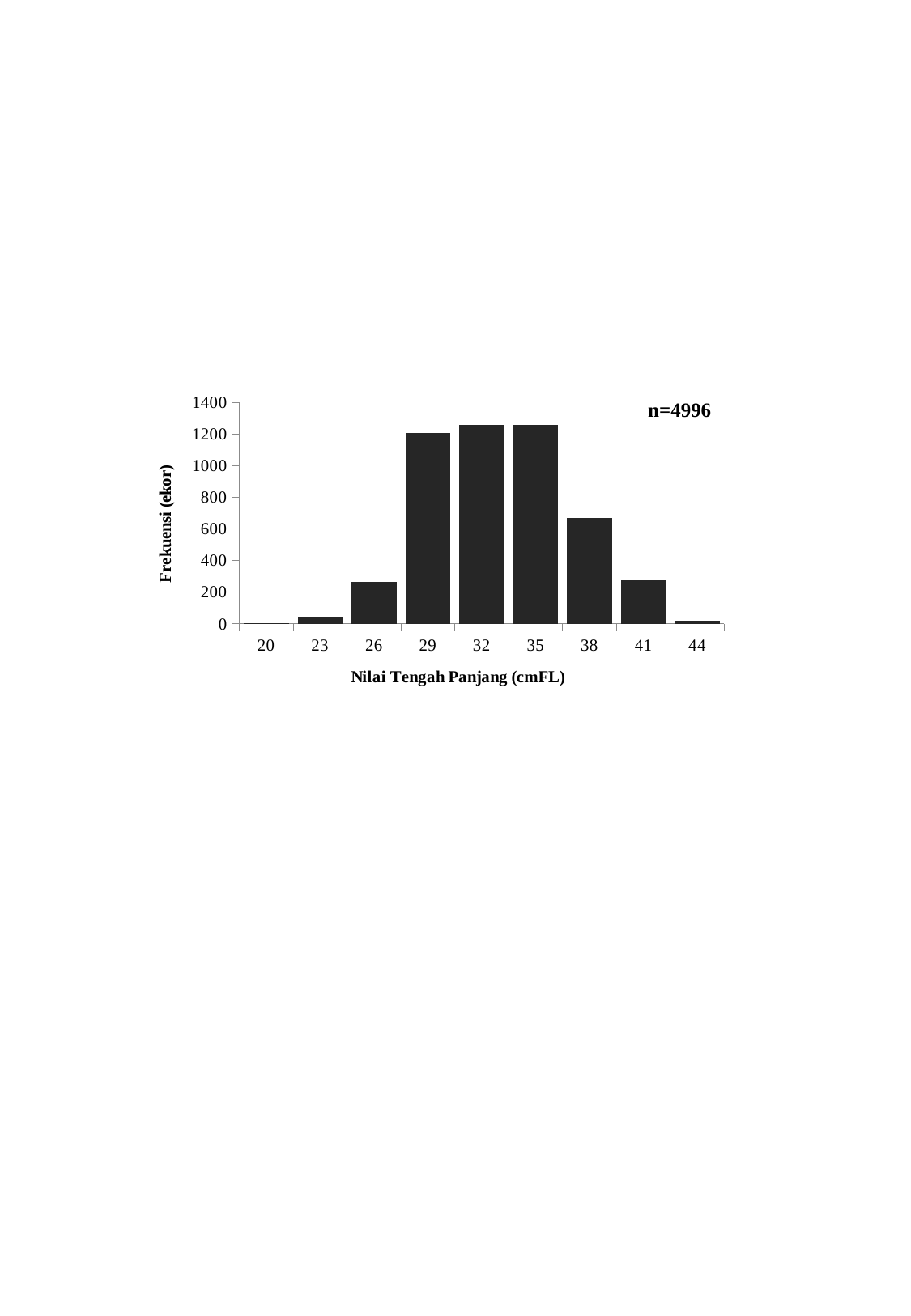
What is the title of the x axis of the chart? Nilai Tengah Panjang (cmFL) What kind of chart is shown on the slide? bar chart Is the frequency for the 26 cmFL category greater or less than 200? greater Is the frequency for the 23 cmFL category greater or less than 200? less Is the frequency for the 29 cmFL category greater or less than 1000? greater Which length category has the lowest frequency? 20 How many length categories are shown on the x axis of the chart? 9 What sample size (n) is annotated on the chart? n=4996 Which has a higher frequency, the 26 cmFL category or the 44 cmFL category? 26 Which has a higher frequency, the 29 cmFL category or the 38 cmFL category? 29